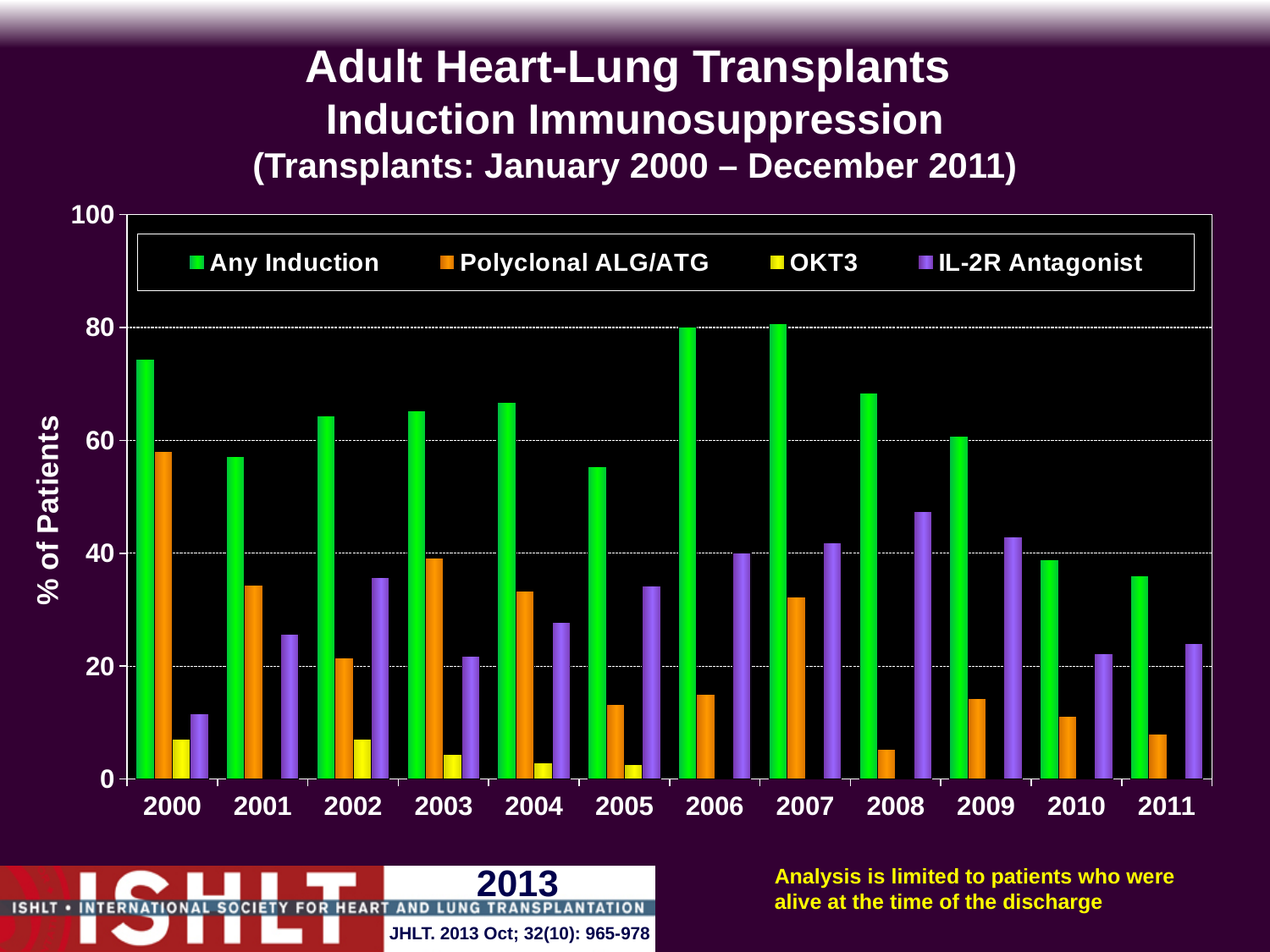
Which is larger in 2000: the Polyclonal ALG/ATG value or the IL-2R Antagonist value? Polyclonal ALG/ATG Does the Any Induction value rise or fall from 2007 to 2011? Fall How many series does the legend list? 4 Is the Any Induction value for 2000 greater or less than 60? greater What kind of chart is shown on the slide? Bar chart In which year is the Polyclonal ALG/ATG value highest? 2000 In which year is the Polyclonal ALG/ATG value lowest? 2008 What is the label on the y axis? % of Patients Is the IL-2R Antagonist value for 2008 greater or less than 40? greater Is the Any Induction value for 2011 greater or less than 40? less How many years are shown along the x axis? 12 In which year is the IL-2R Antagonist value highest? 2008